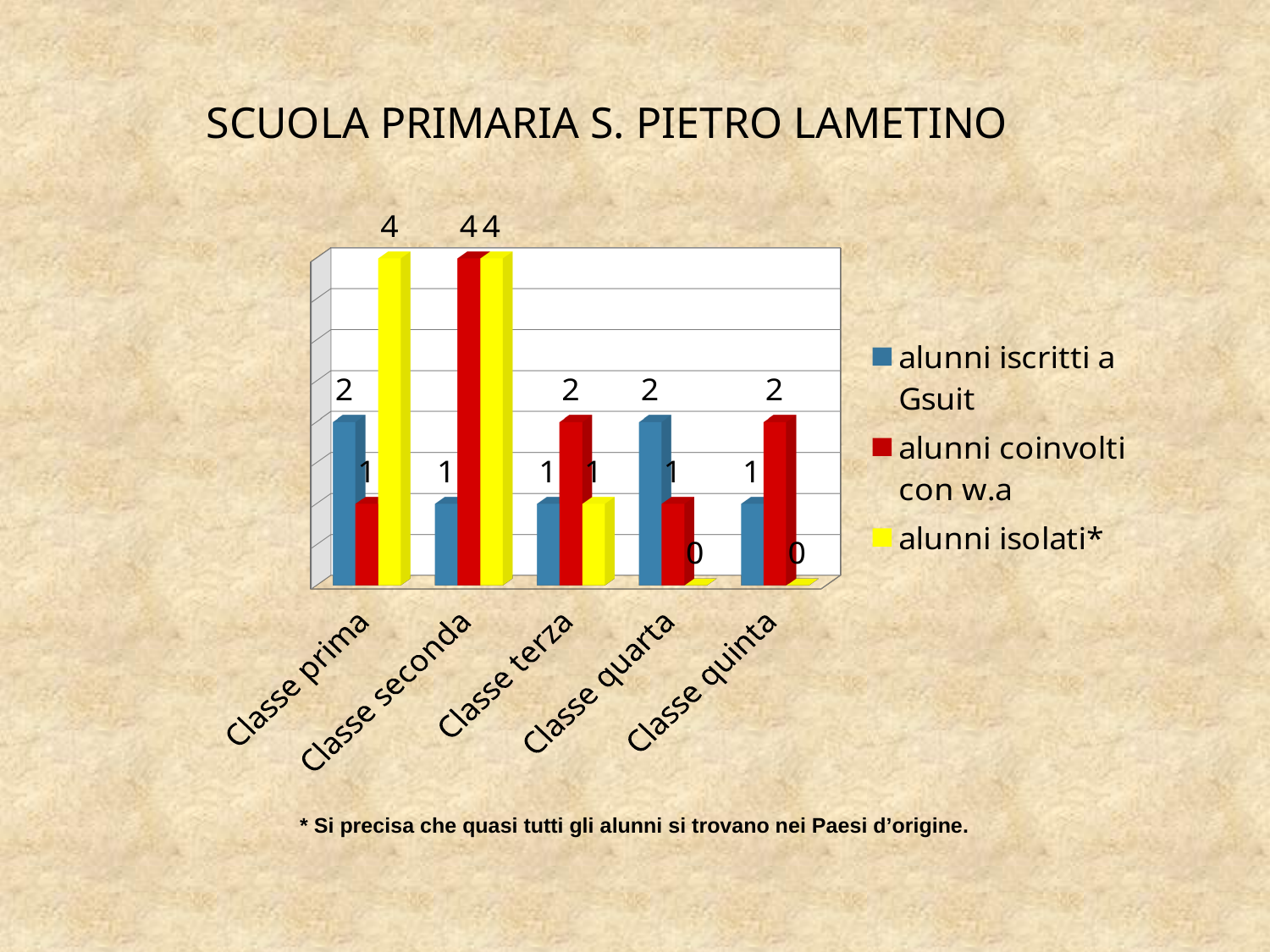
How many series does the legend list? 3 What kind of chart is shown on the slide? Bar chart What is the difference between 'alunni isolati*' for Classe prima and for Classe terza? 3 What is the value of 'alunni coinvolti con w.a' for Classe seconda? 4 What is the value of 'alunni iscritti a Gsuit' for Classe quarta? 2 Which class has the lowest value for 'alunni isolati*'? Classe quarta and Classe quinta How many classes are shown on the x axis? 5 Which class has the highest value for 'alunni coinvolti con w.a'? Classe seconda What is the value of 'alunni isolati*' for Classe quinta? 0 For Classe terza, which is larger: 'alunni iscritti a Gsuit' or 'alunni coinvolti con w.a'? alunni coinvolti con w.a What is the value of 'alunni isolati*' for Classe prima? 4 Which colour represents 'alunni isolati*' in the legend? Yellow